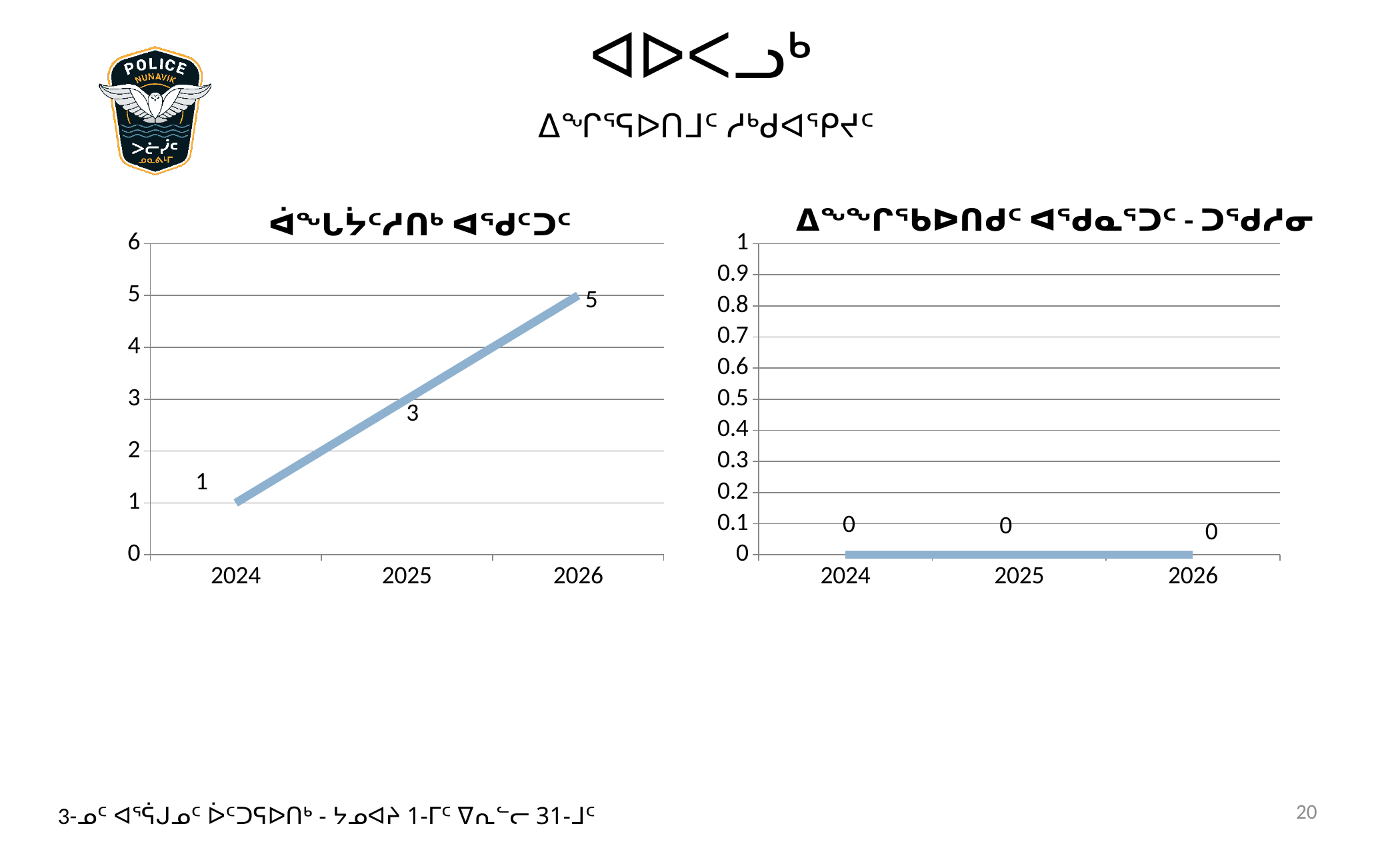
What kind of chart is the left chart? line chart On the right chart, what is the value for 2025? 0 On the left chart, what is the difference between the values for 2026 and 2024? 4 On the left chart, which is larger, the value for 2025 or the value for 2024? 2025 On the left chart, what is the value for 2025? 3 On the left chart, how many years are plotted on the x axis? 3 On the left chart, what is the value for 2024? 1 On the left chart, which year has the lowest value? 2024 On the right chart, do the values rise, fall, or stay flat from 2024 to 2026? stay flat On the left chart, which year has the highest value? 2026 On the left chart, do the values rise or fall from 2024 to 2026? rise On the left chart, what is the value for 2026? 5